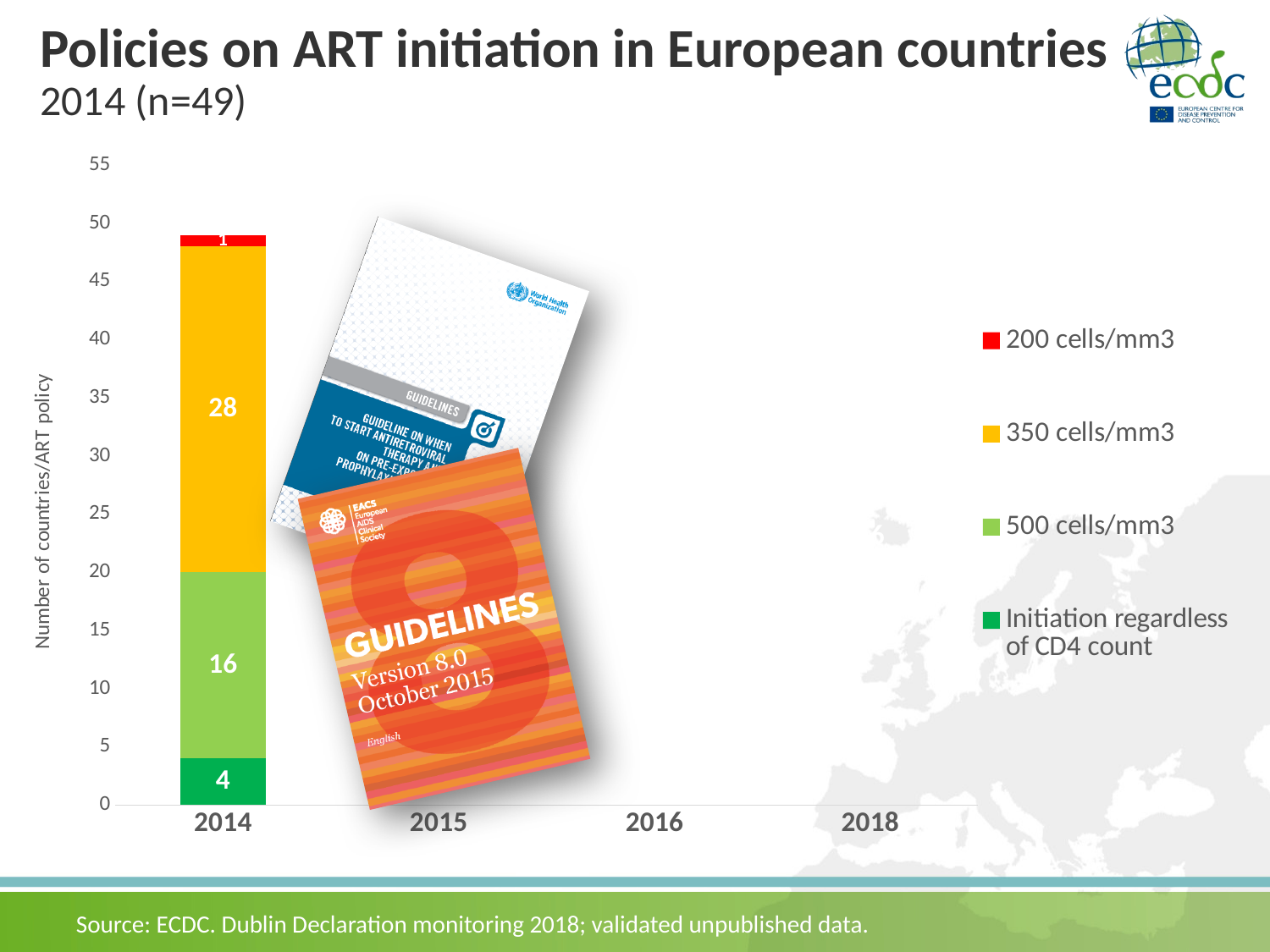
In the 2014 bar, what is the value for the 200 cells/mm3 segment? 1 In the 2014 bar, what is the value for the 500 cells/mm3 segment? 16 In the 2014 bar, what is the value for the 350 cells/mm3 segment? 28 How many series does the legend list? 4 What kind of chart is shown on the slide? stacked bar chart Which segment of the 2014 bar has the largest value? 350 cells/mm3 What is the label of the vertical axis? Number of countries/ART policy What is the difference between the 350 cells/mm3 and 500 cells/mm3 values in the 2014 bar? 12 In the 2014 bar, which is larger: the 500 cells/mm3 segment or the 'Initiation regardless of CD4 count' segment? 500 cells/mm3 In the 2014 bar, what is the value for the 'Initiation regardless of CD4 count' segment? 4 Which segment of the 2014 bar has the smallest value? 200 cells/mm3 What is the total of the 2014 stacked bar? 49